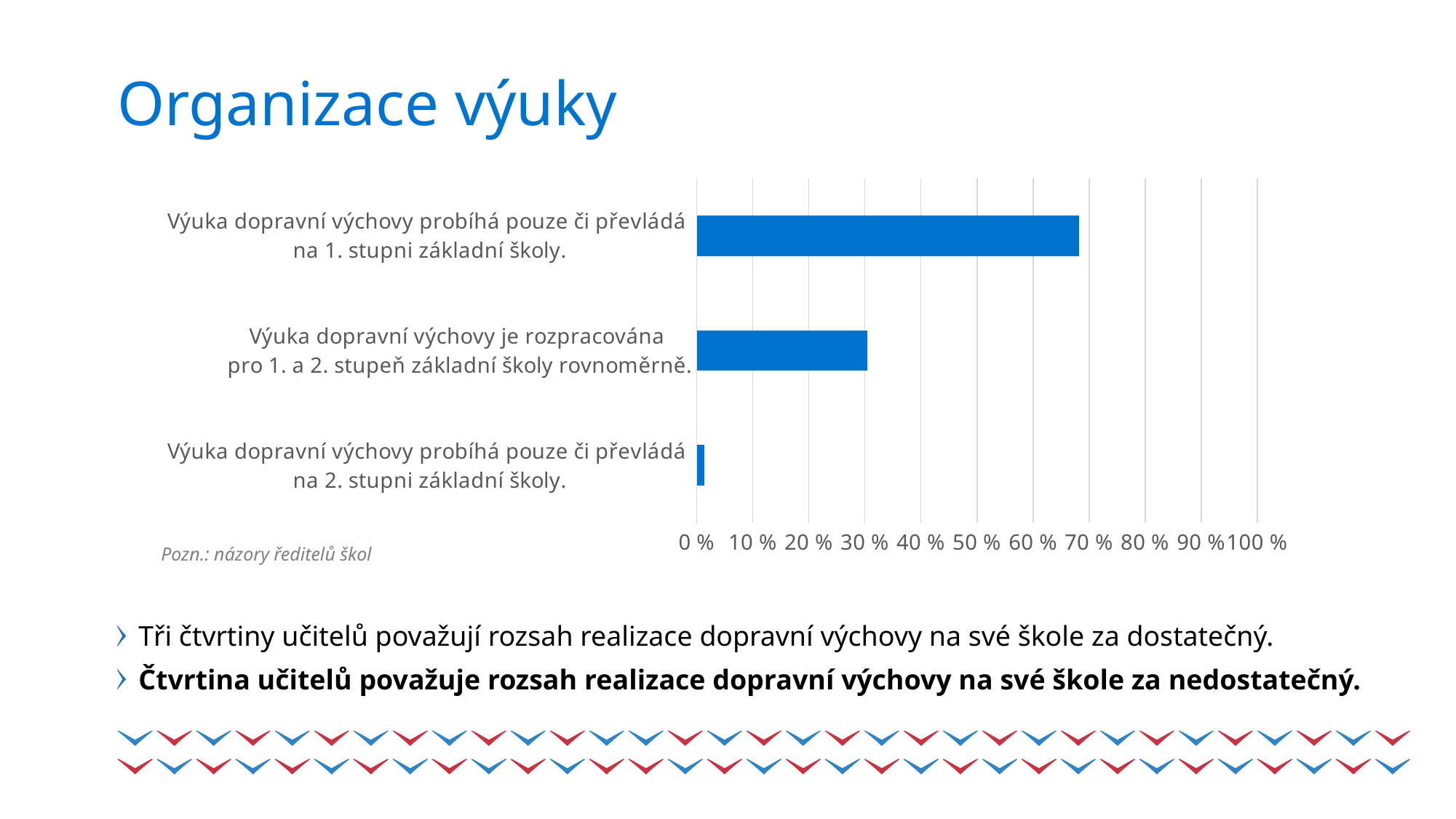
Is the value for 'Výuka dopravní výchovy je rozpracována pro 1. a 2. stupeň základní školy rovnoměrně.' greater or less than 40 %? less Is the value for 'Výuka dopravní výchovy je rozpracována pro 1. a 2. stupeň základní školy rovnoměrně.' greater or less than 20 %? greater What is the title of the slide containing the chart? Organizace výuky How many categories does the chart show? 3 What kind of chart is shown on the slide? bar chart What is the maximum value shown on the chart's horizontal axis? 100 % Which is larger: the value for 'Výuka dopravní výchovy je rozpracována pro 1. a 2. stupeň základní školy rovnoměrně.' or the value for 'Výuka dopravní výchovy probíhá pouze či převládá na 2. stupni základní školy.'? Výuka dopravní výchovy je rozpracována pro 1. a 2. stupeň základní školy rovnoměrně. Which category has the highest value? Výuka dopravní výchovy probíhá pouze či převládá na 1. stupni základní školy. Is the value for 'Výuka dopravní výchovy probíhá pouze či převládá na 2. stupni základní školy.' greater or less than 10 %? less Which category has the lowest value? Výuka dopravní výchovy probíhá pouze či převládá na 2. stupni základní školy.